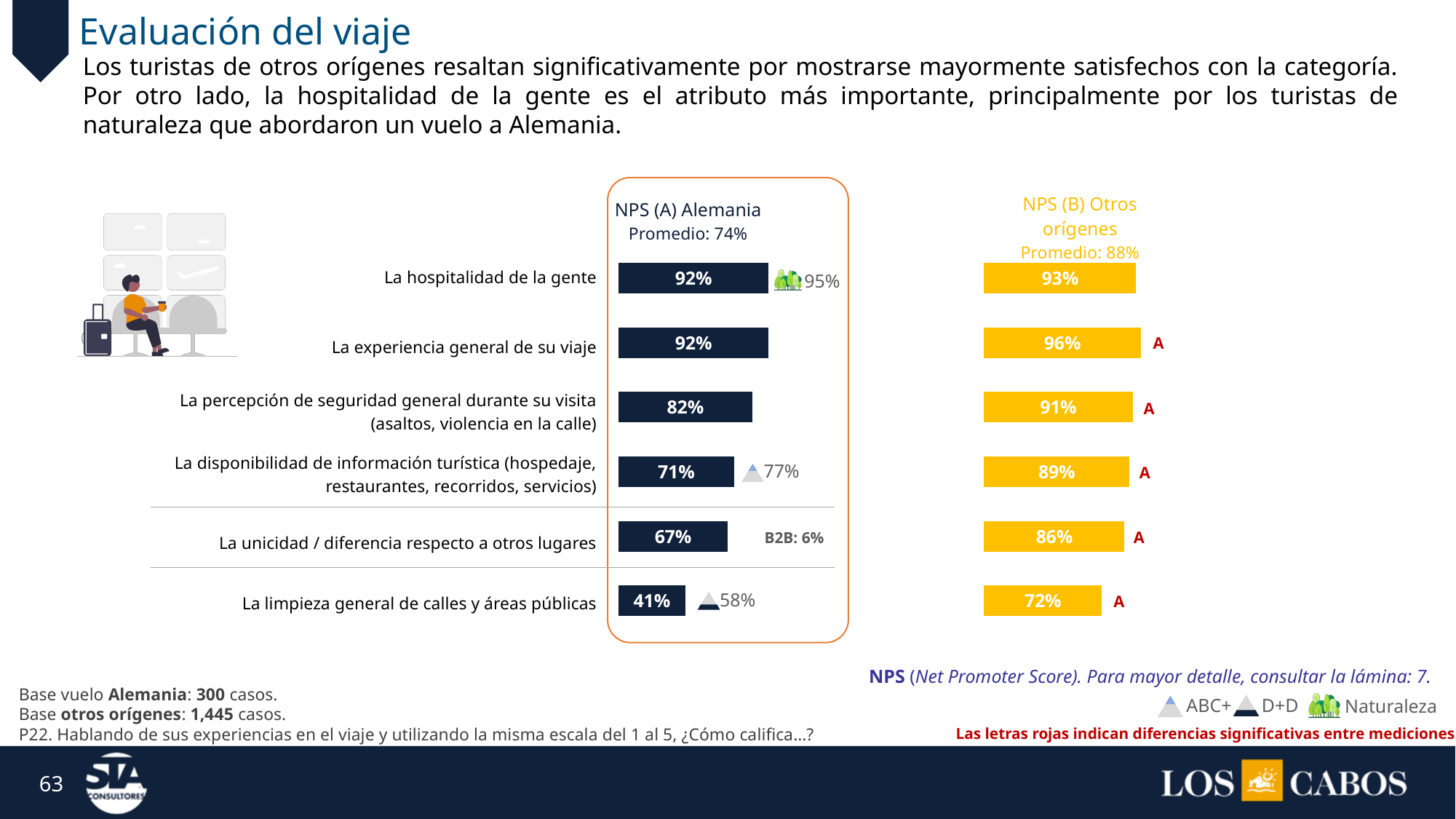
In the NPS (B) Otros orígenes chart, what is the value for 'La disponibilidad de información turística'? 89% In the NPS (A) Alemania chart, which attribute has the lowest value? La limpieza general de calles y áreas públicas In the NPS (A) Alemania chart, what is the value for 'La percepción de seguridad general durante su visita'? 82% For 'La experiencia general de su viaje', which is larger: the NPS (A) Alemania value or the NPS (B) Otros orígenes value? NPS (B) Otros orígenes What is the 'Promedio' shown for NPS (B) Otros orígenes? 88% In the NPS (B) Otros orígenes chart, which attribute has the lowest value? La limpieza general de calles y áreas públicas In the NPS (A) Alemania chart, what is the value for 'La limpieza general de calles y áreas públicas'? 41% What is the difference between the NPS (B) Otros orígenes value and the NPS (A) Alemania value for 'La unicidad / diferencia respecto a otros lugares'? 19 percentage points What kind of chart is used to show the NPS (A) Alemania values? Bar chart How many attributes are listed in the NPS (A) Alemania chart? 6 In the NPS (B) Otros orígenes chart, which attribute has the highest value? La experiencia general de su viaje What is the difference between the NPS (B) Otros orígenes value and the NPS (A) Alemania value for 'La limpieza general de calles y áreas públicas'? 31 percentage points